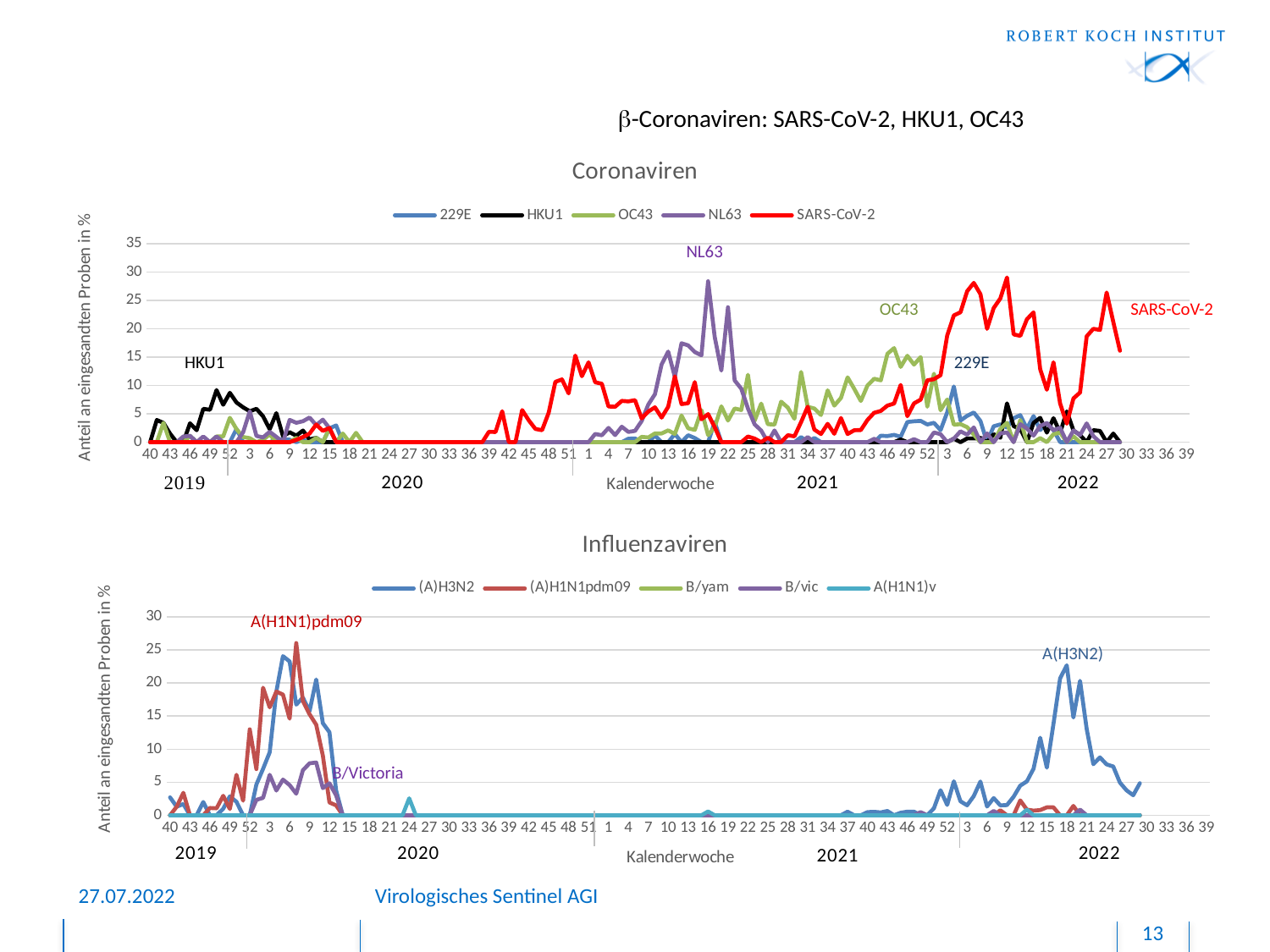
In the "Influenzaviren" chart, is the peak value of B/Victoria greater or less than 10? less In the "Coronaviren" chart, what colour is the SARS-CoV-2 line? red In the "Influenzaviren" chart, is the peak value of A(H3N2) in 2022 greater or less than 20? greater In the "Coronaviren" chart, is the peak value of HKU1 greater or less than 15? less What kind of chart is the "Coronaviren" chart? line chart How many series does the legend of the "Coronaviren" chart list? 5 How many series does the legend of the "Influenzaviren" chart list? 5 What kind of chart is the "Influenzaviren" chart? line chart What is the y-axis title of the "Influenzaviren" chart? Anteil an eingesandten Proben in %